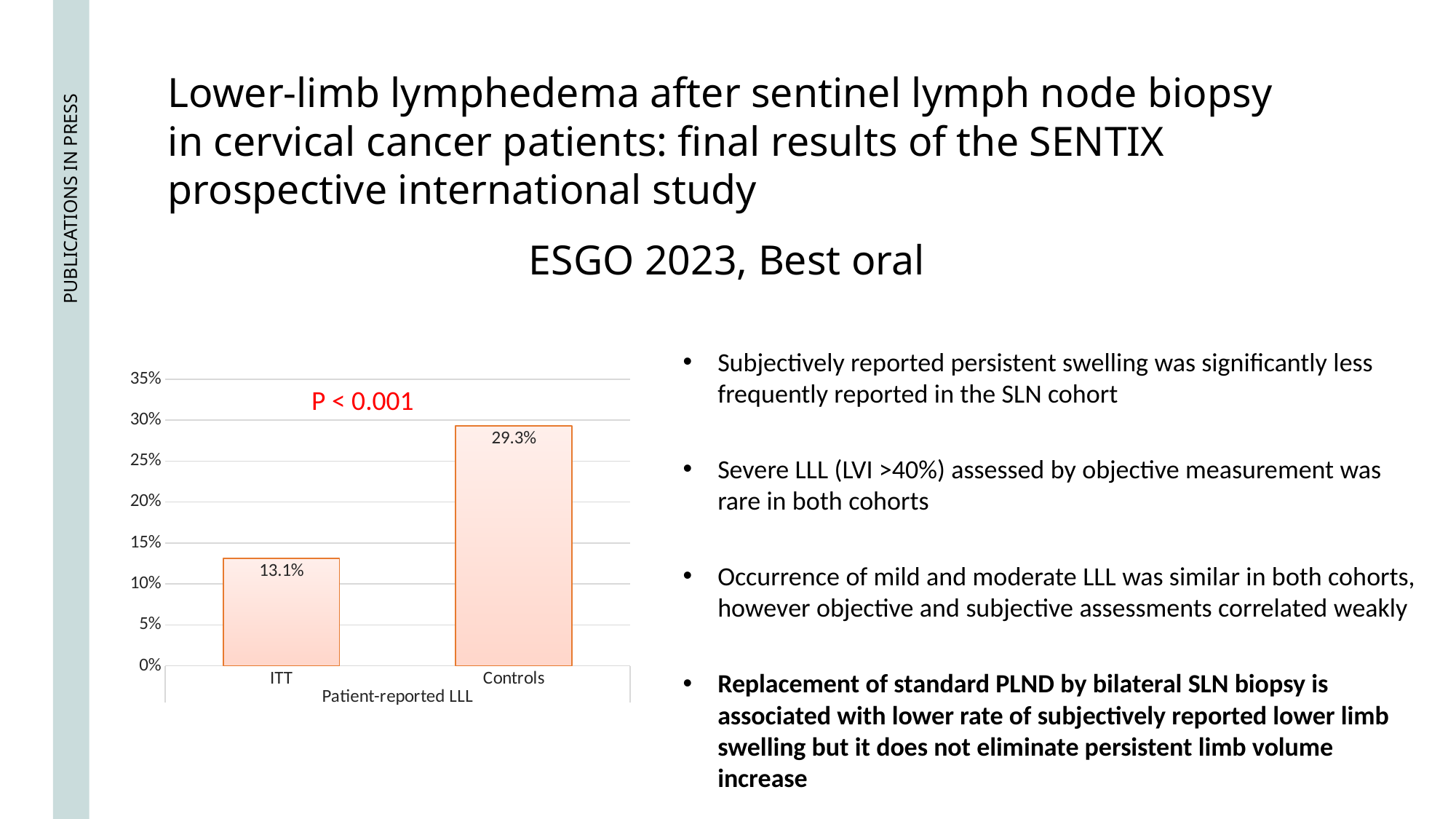
Which category has the lowest value in the chart? ITT Is the value for Controls greater or less than 25%? greater What is the x-axis label of the chart? Patient-reported LLL Which category has the highest value in the chart? Controls What is the value for Controls in the Patient-reported LLL chart? 29.3% What is the value for ITT in the Patient-reported LLL chart? 13.1% Is the value for ITT greater or less than 15%? less What p-value is printed on the chart? P < 0.001 How many categories are shown in the chart? 2 What is the difference between the Controls value and the ITT value? 16.2% What kind of chart is shown on the slide? Bar chart Which is larger, the value for ITT or the value for Controls? Controls